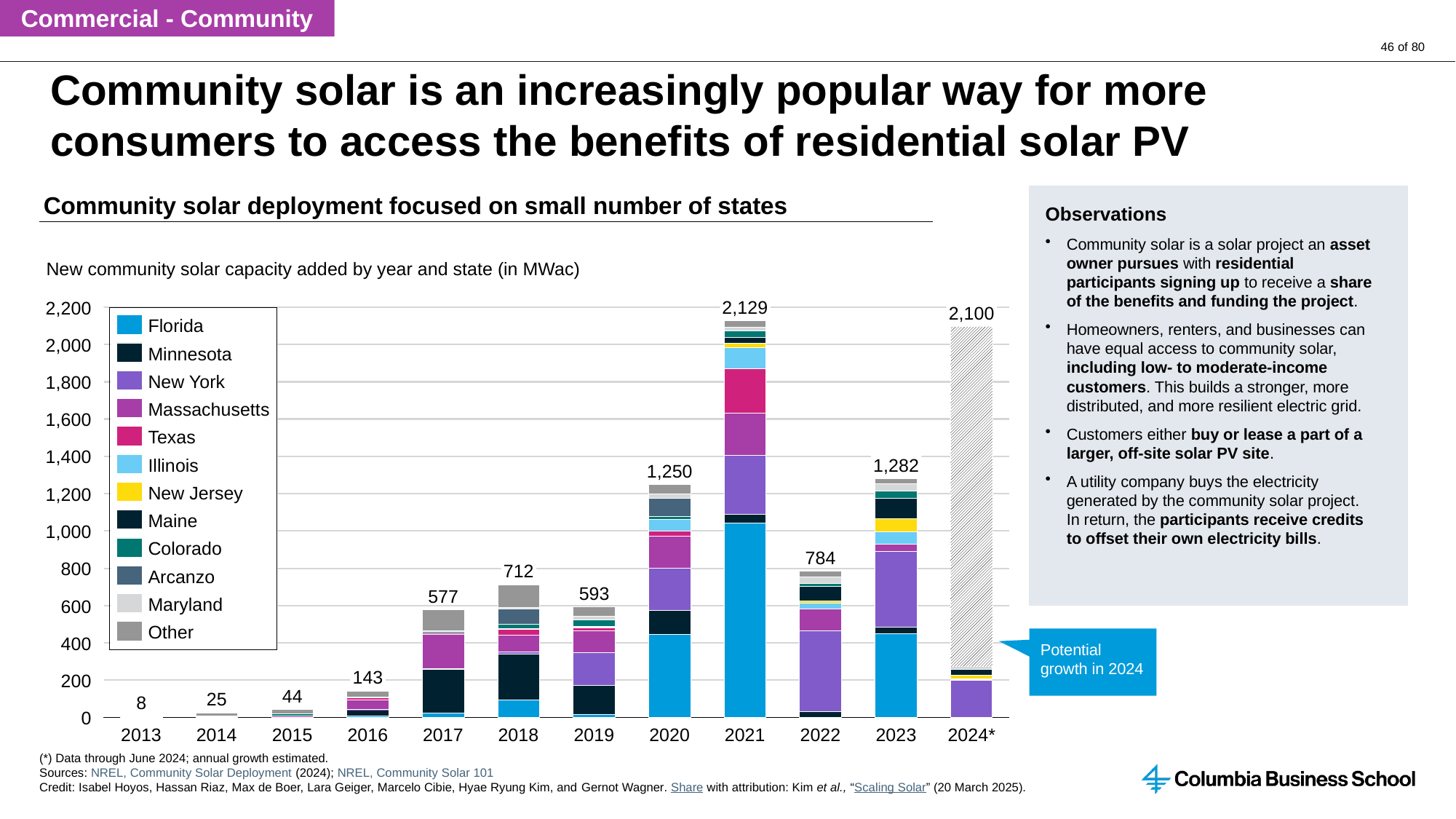
Which year has the highest total new community solar capacity added? 2021 Which year has a larger total, 2018 or 2019? 2018 How many years are shown on the x axis of the chart? 12 Is the Florida segment in 2021 greater or less than 1,000? greater Do the total values rise or fall from 2013 to 2021? Rise What is the difference between the totals for 2021 and 2020? 879 What is the total value shown for 2016? 143 What is the total new community solar capacity added in 2021? 2,129 Which year has the lowest total new community solar capacity added? 2013 How many states or categories does the legend list? 12 What kind of chart is used to show new community solar capacity added by year and state? Stacked bar chart What is the total new community solar capacity added in 2020? 1,250